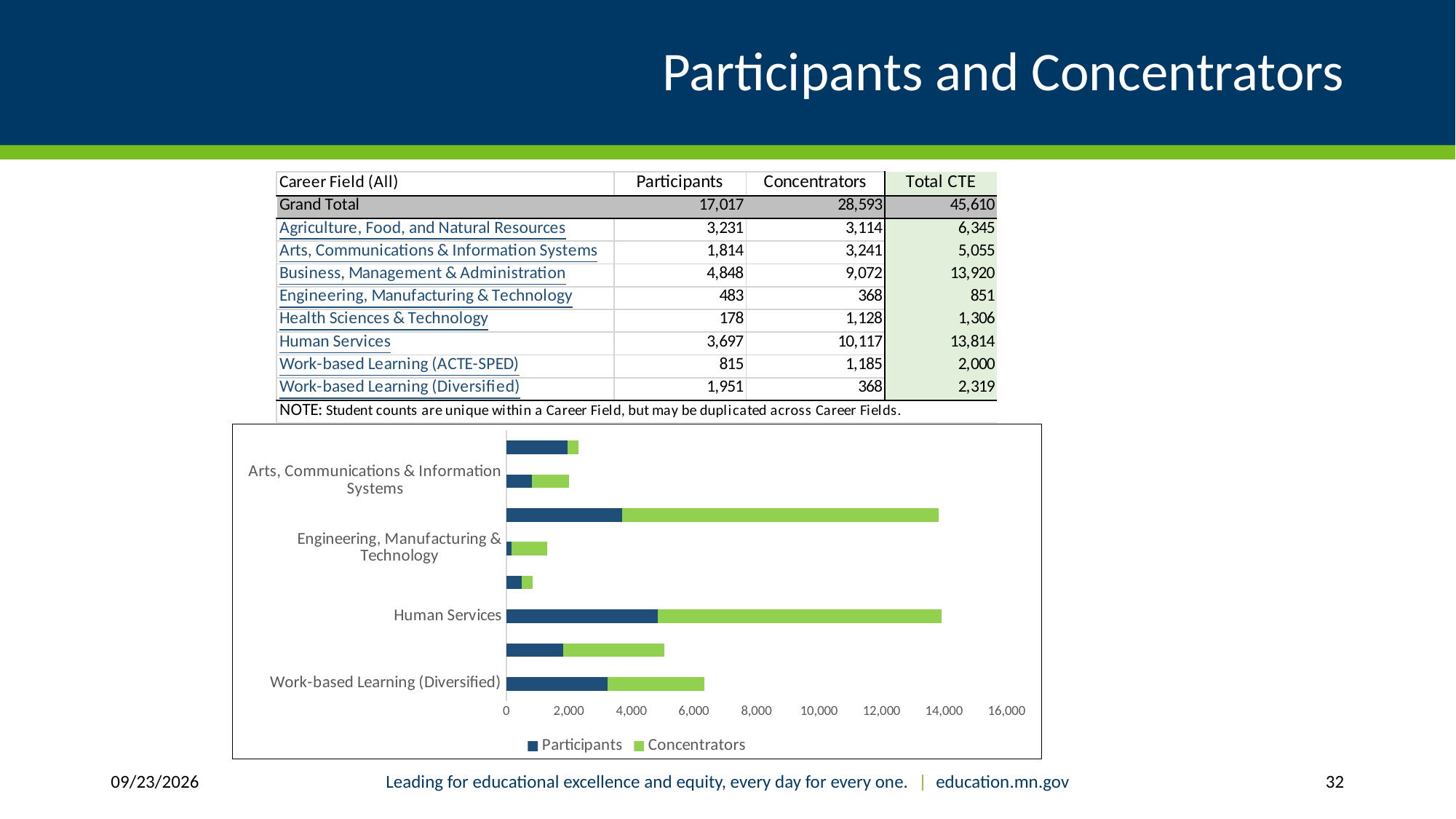
In the Human Services bar, which segment is larger, Participants or Concentrators? Concentrators What colour represents Concentrators in the chart? Green How many bars are plotted in the chart? 8 What are the two series named in the chart legend? Participants and Concentrators Is the total length of the Human Services bar greater or less than 12,000? greater What is the highest value shown on the chart's horizontal axis? 16,000 Is the total length of the Engineering, Manufacturing & Technology bar greater or less than 2,000? less How many series does the chart legend list? 2 What kind of chart is shown on the slide? Stacked bar chart